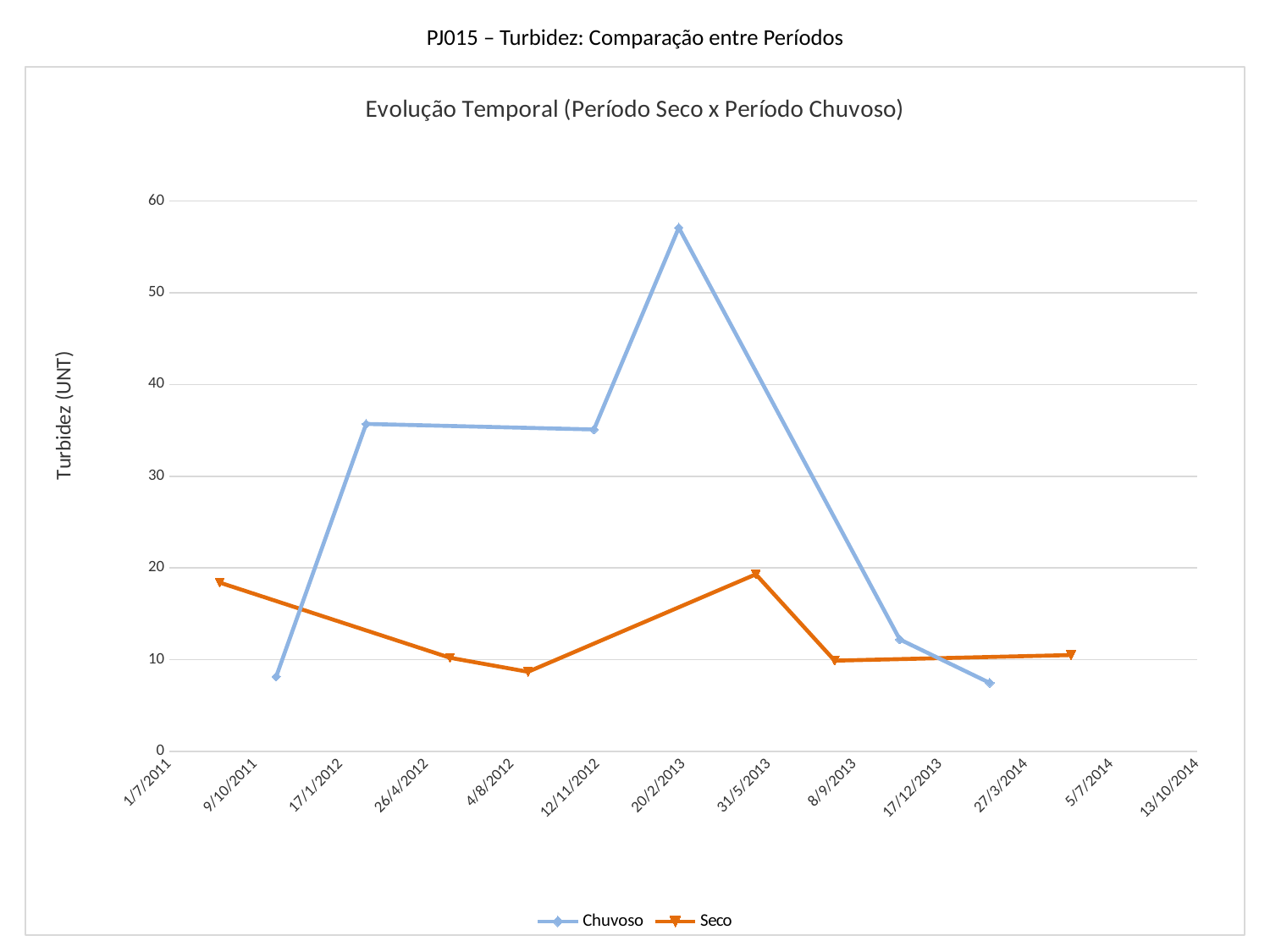
Is the highest value of the Chuvoso series greater or less than 50? greater Is the first plotted point of the Chuvoso series greater or less than 10? less How many data points are plotted for the Seco series? 6 How many data points are plotted for the Chuvoso series? 6 What kind of chart is shown on the slide? line chart How many series does the legend list? 2 Is the first plotted point of the Seco series greater or less than 10? greater After its peak in early 2013, does the Chuvoso series rise or fall toward its last point? fall Which series reaches the higher peak value, Chuvoso or Seco? Chuvoso What is the label on the vertical axis? Turbidez (UNT) What are the two series named in the legend? Chuvoso and Seco